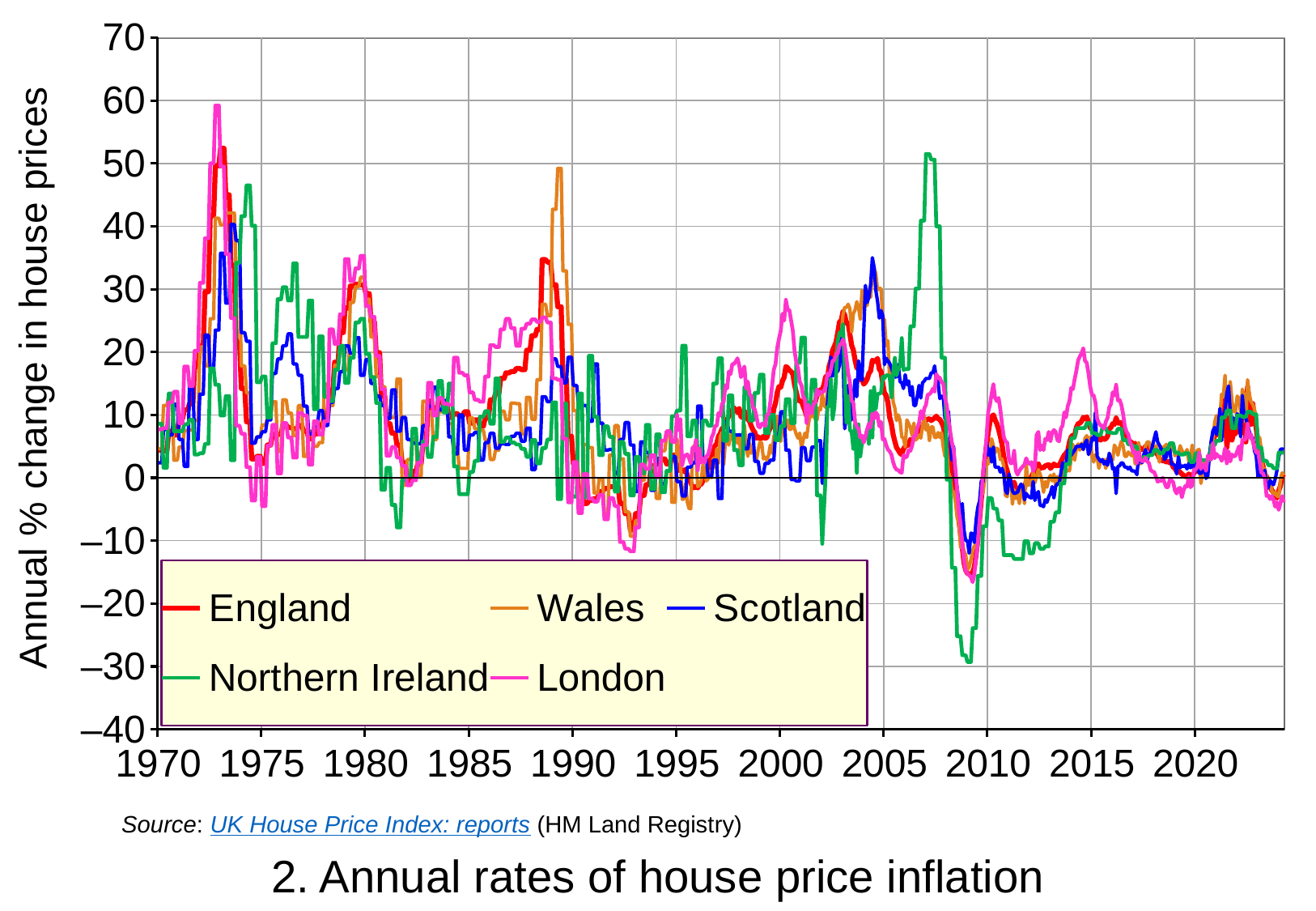
What is the label on the y axis? Annual % change in house prices At the peak around 1973, which series reaches a higher value, London or Scotland? London Which series reaches the highest value anywhere on the chart? London What is the title of the chart? 2. Annual rates of house price inflation Is the peak value for Wales around 1989 greater or less than 40? greater Is the peak value for Northern Ireland around 2007 greater or less than 40? greater How many series does the legend list? 5 Is the lowest value for Northern Ireland around 2009 greater or less than -20? less What kind of chart is shown on the slide? line chart Around 2009, which series falls to a lower value, Northern Ireland or England? Northern Ireland